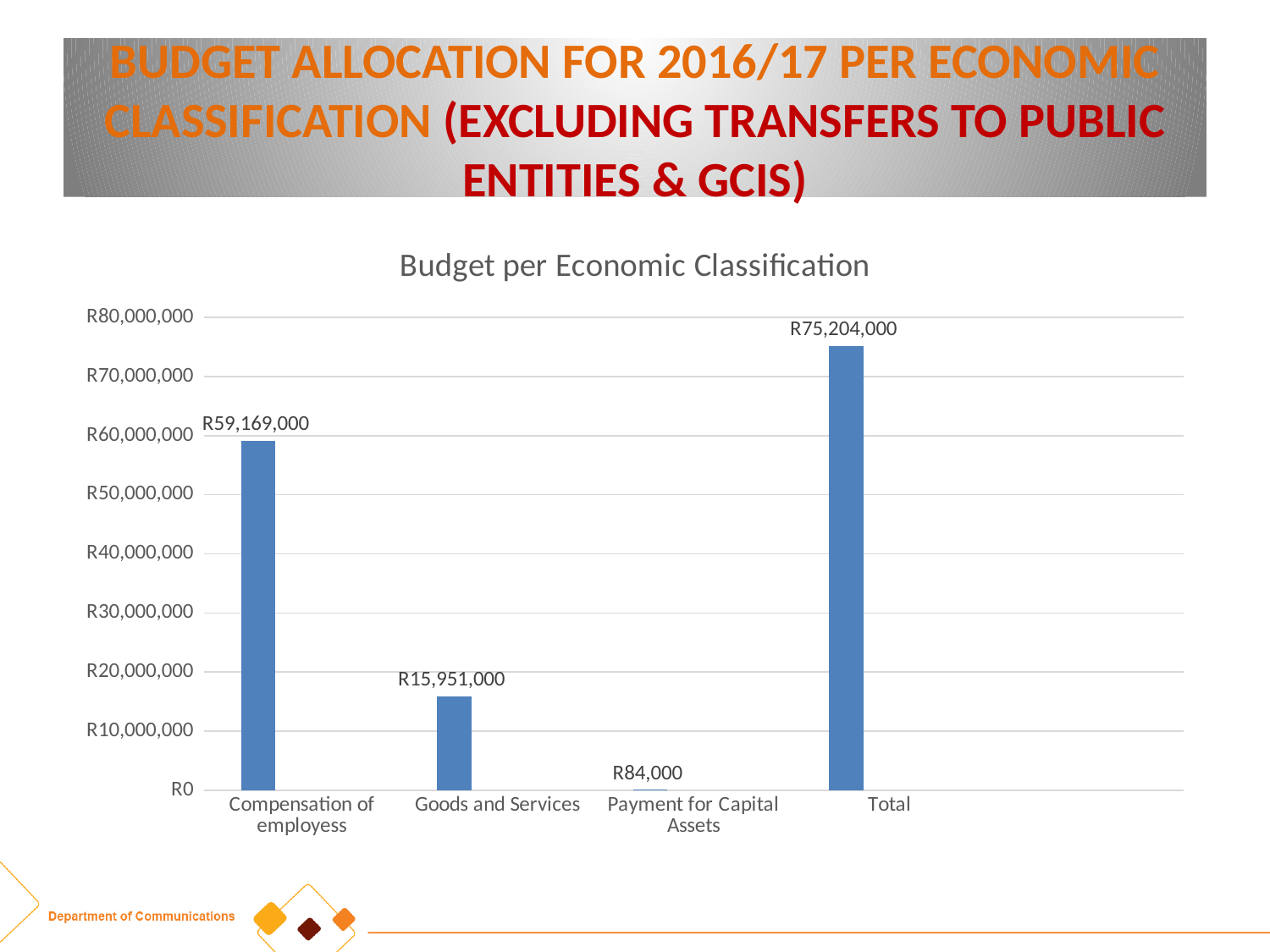
What is the value for Total? R75,204,000 Which category has the highest value? Total What is the value for Compensation of employess? R59,169,000 Is the value for Goods and Services greater or less than R20,000,000? less What kind of chart is shown? bar chart What is the difference between Compensation of employess and Goods and Services? R43,218,000 Which is larger, Compensation of employess or Goods and Services? Compensation of employess What is the title of the chart? Budget per Economic Classification How many categories are shown on the x axis? 4 What is the value for Payment for Capital Assets? R84,000 Which category has the lowest value? Payment for Capital Assets What is the value for Goods and Services? R15,951,000